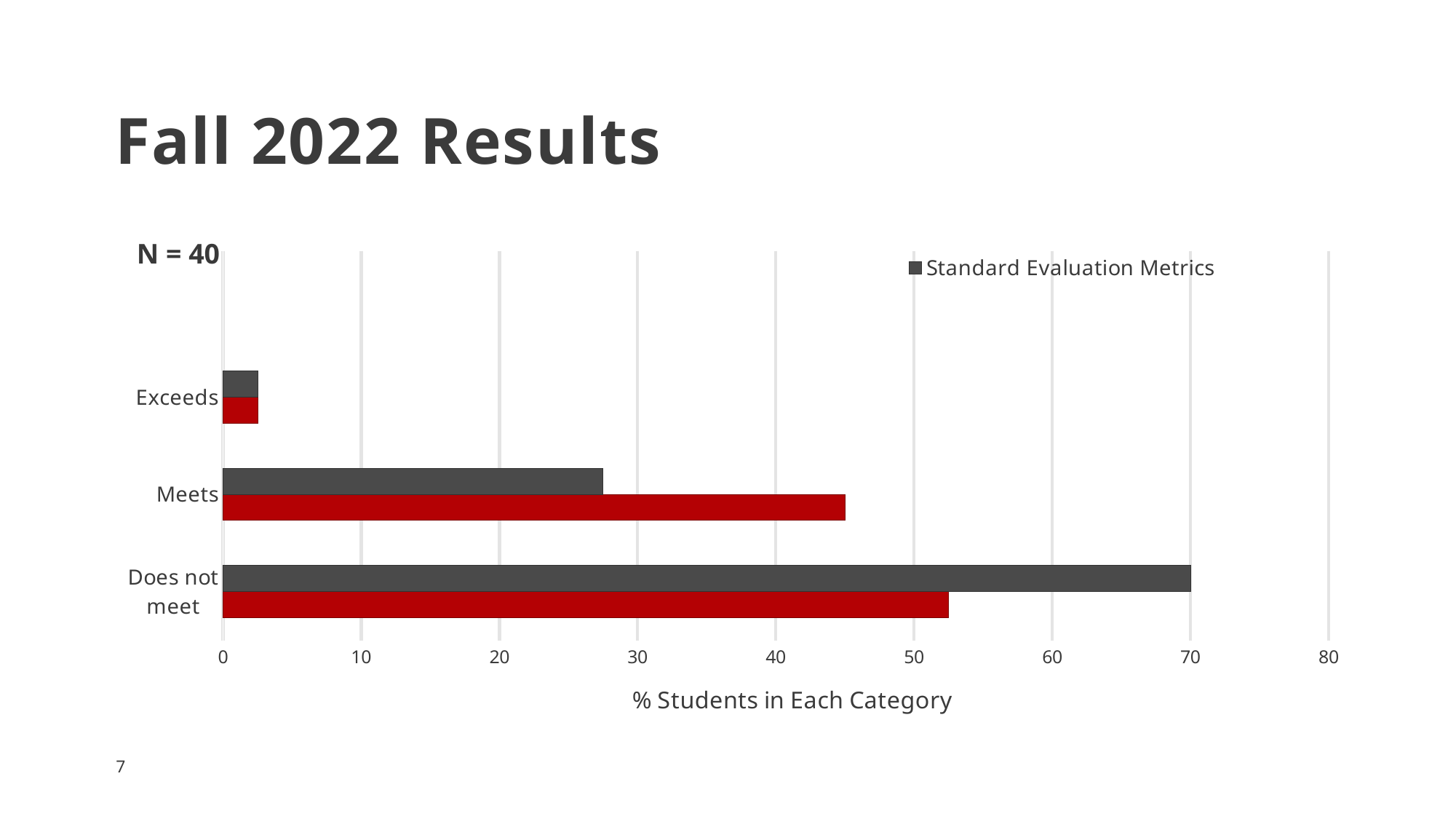
How many categories are shown on the chart? 3 For Meets, which bar is larger: the Standard Evaluation Metrics bar or the red bar? the red bar Is the red bar's value for Does not meet greater or less than 50? greater What is the title of the horizontal axis? % Students in Each Category What is the Standard Evaluation Metrics value for Does not meet? 70 Is the Standard Evaluation Metrics value for Meets greater or less than 30? less What kind of chart is shown on the slide? bar chart Which category has the highest value for Standard Evaluation Metrics? Does not meet For Does not meet, which bar is larger: the Standard Evaluation Metrics bar or the red bar? Standard Evaluation Metrics Is the red bar's value for Meets greater or less than 40? greater Which category has the lowest value for Standard Evaluation Metrics? Exceeds How many series does the chart's legend list? 1